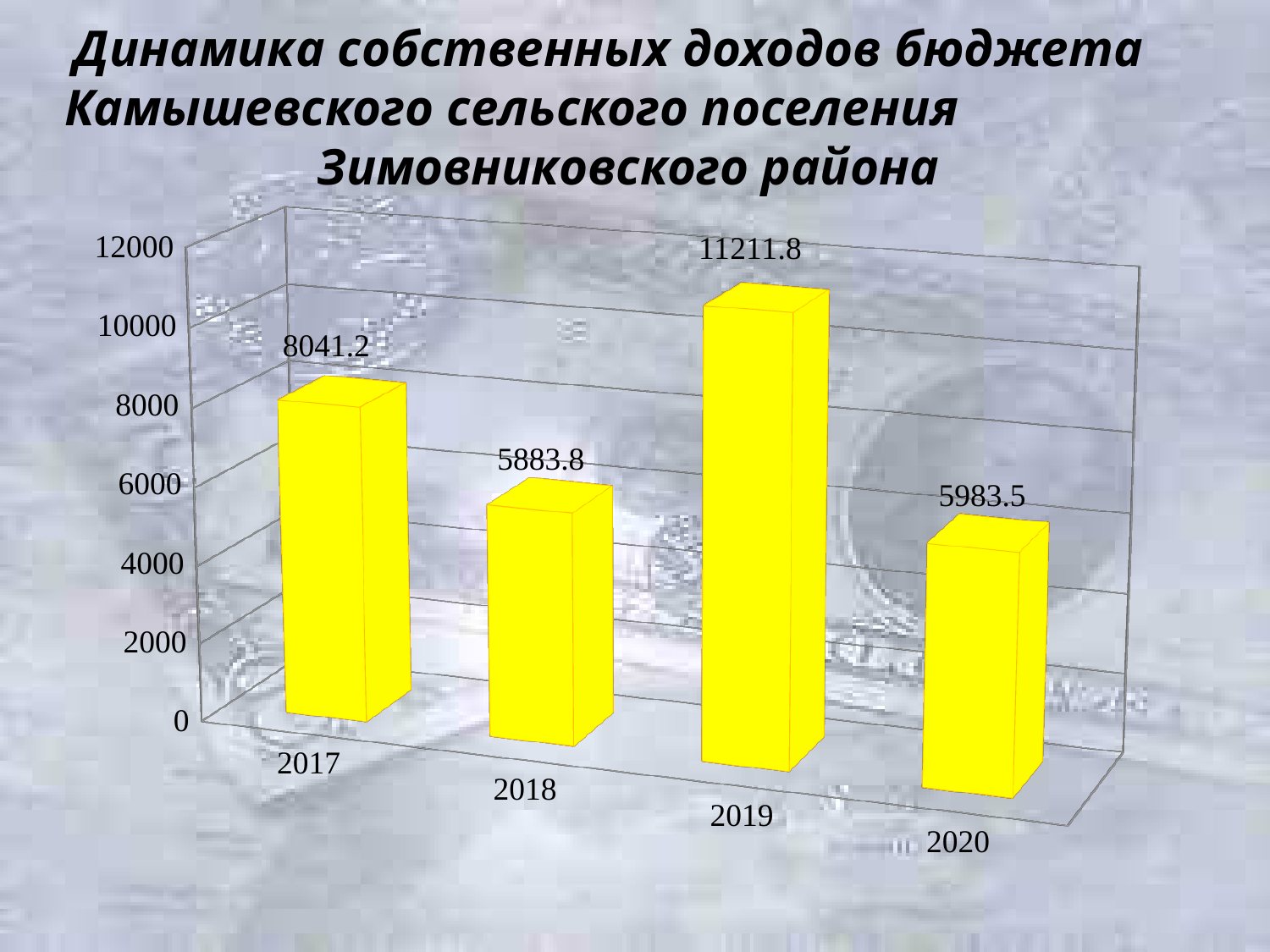
Which year has the lowest value? 2018 What is the value for 2017? 8041.2 What colour are the bars in the chart? yellow What is the difference between the values for 2020 and 2018? 99.7 Which is larger, the value for 2017 or the value for 2020? 2017 What is the value for 2020? 5983.5 What is the difference between the values for 2019 and 2017? 3170.6 What kind of chart is shown on the slide? bar chart Is the value for 2019 greater or less than 10000? greater What is the value for 2019? 11211.8 Which year has the highest value? 2019 How many years are shown on the chart? 4